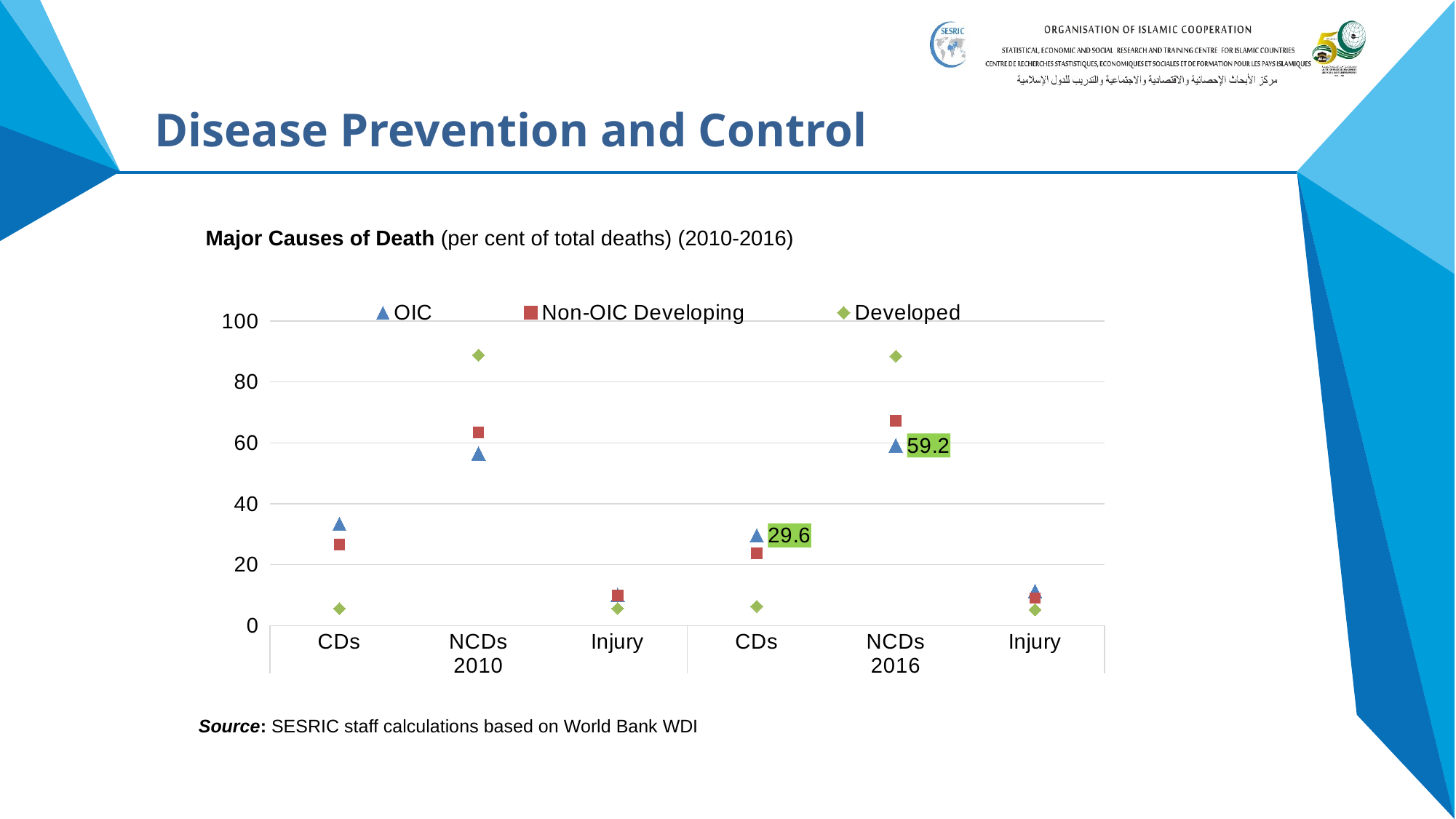
Which series has the highest value for NCDs in 2010? Developed How many categories are shown along the x axis? 6 For CDs in 2010, which is larger: the OIC value or the Non-OIC Developing value? OIC What is the value for OIC for NCDs in 2016? 59.2 Which series has the lowest value for CDs in 2010? Developed Is the value for OIC for CDs in 2010 greater or less than 40? less How many series does the legend list? 3 Is the value for Non-OIC Developing for NCDs in 2016 greater or less than 60? greater What is the value for OIC for CDs in 2016? 29.6 What is the title of the chart? Major Causes of Death (per cent of total deaths) (2010-2016) Is the value for Developed for NCDs in 2010 greater or less than 80? greater What is the difference between the OIC values for NCDs and CDs in 2016? 29.6